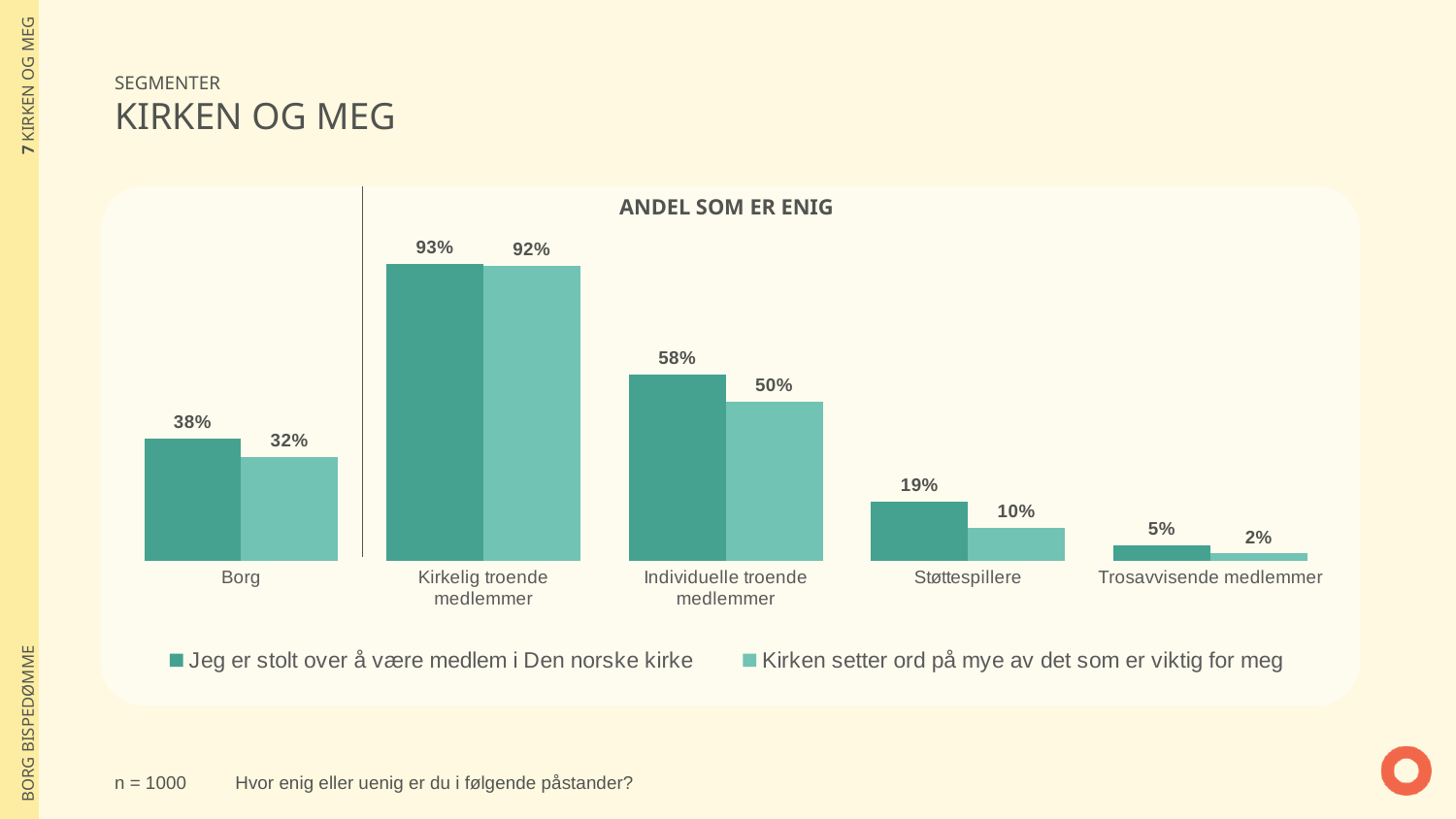
What is the difference between the two series for Støttespillere? 9 percentage points What is the value for Borg in the series 'Jeg er stolt over å være medlem i Den norske kirke'? 38% Which category has the highest value for 'Jeg er stolt over å være medlem i Den norske kirke'? Kirkelig troende medlemmer What is the value for Individuelle troende medlemmer in the series 'Jeg er stolt over å være medlem i Den norske kirke'? 58% For Borg, which series has the larger value? Jeg er stolt over å være medlem i Den norske kirke What is the title of the chart? ANDEL SOM ER ENIG How many series does the legend list? 2 Which category has the lowest value for 'Kirken setter ord på mye av det som er viktig for meg'? Trosavvisende medlemmer How many categories are shown on the x axis? 5 What is the value for Støttespillere in the series 'Kirken setter ord på mye av det som er viktig for meg'? 10% What is the difference between the two series for Individuelle troende medlemmer? 8 percentage points What kind of chart is shown on the slide? Bar chart